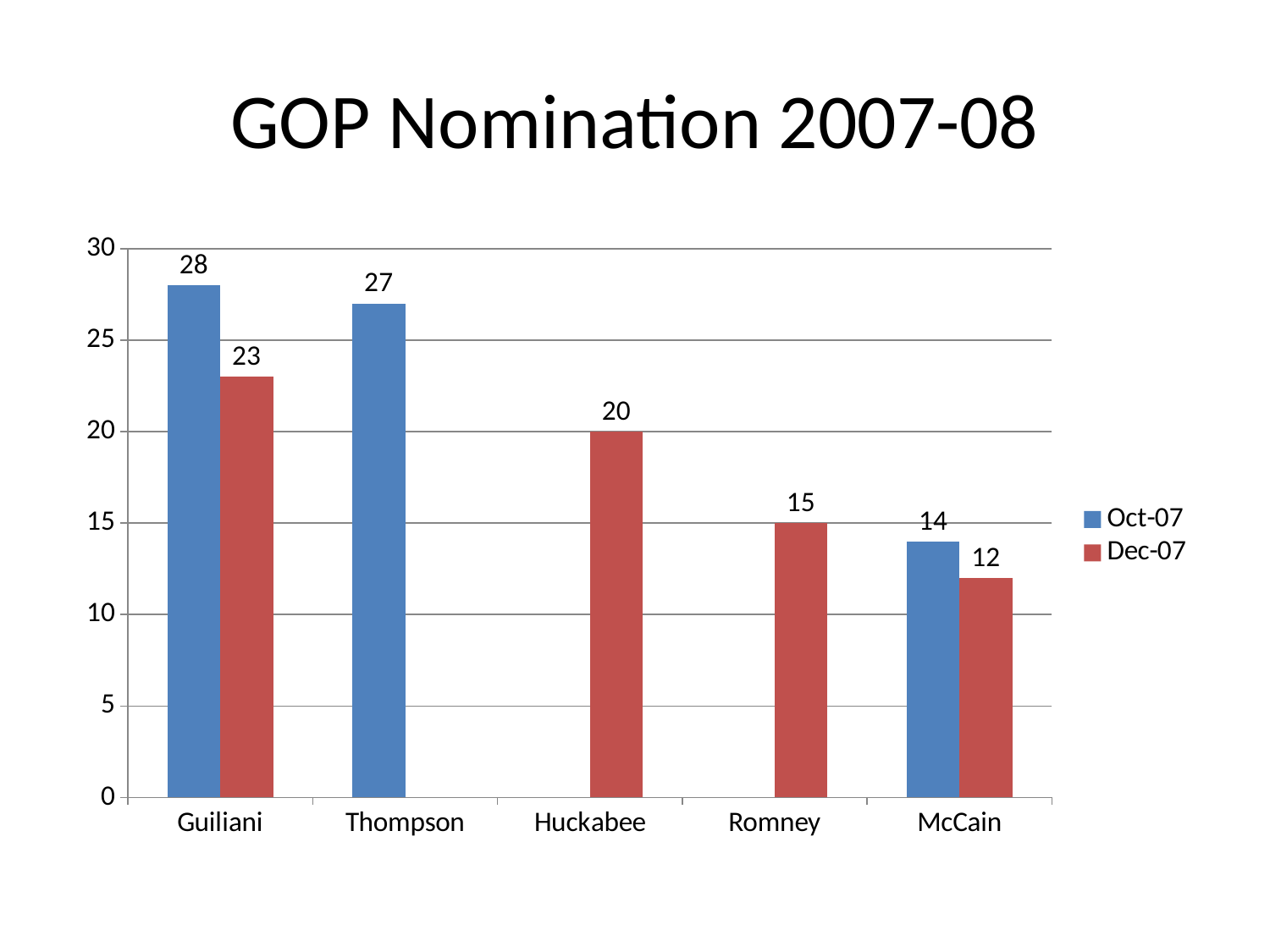
Which candidate has the lowest Dec-07 value? McCain What is the difference between Guiliani's Oct-07 and Dec-07 values? 5 How many candidates are shown on the x axis? 5 How many series does the legend list? 2 Which is larger, Romney's Dec-07 value or McCain's Dec-07 value? Romney's Dec-07 value What is the Dec-07 value for McCain? 12 What kind of chart is shown on the slide? Bar chart What is the Oct-07 value for Guiliani? 28 Which candidate has the highest Dec-07 value? Guiliani What is the Dec-07 value for Huckabee? 20 What is the Oct-07 value for Thompson? 27 What is the title of the chart? GOP Nomination 2007-08